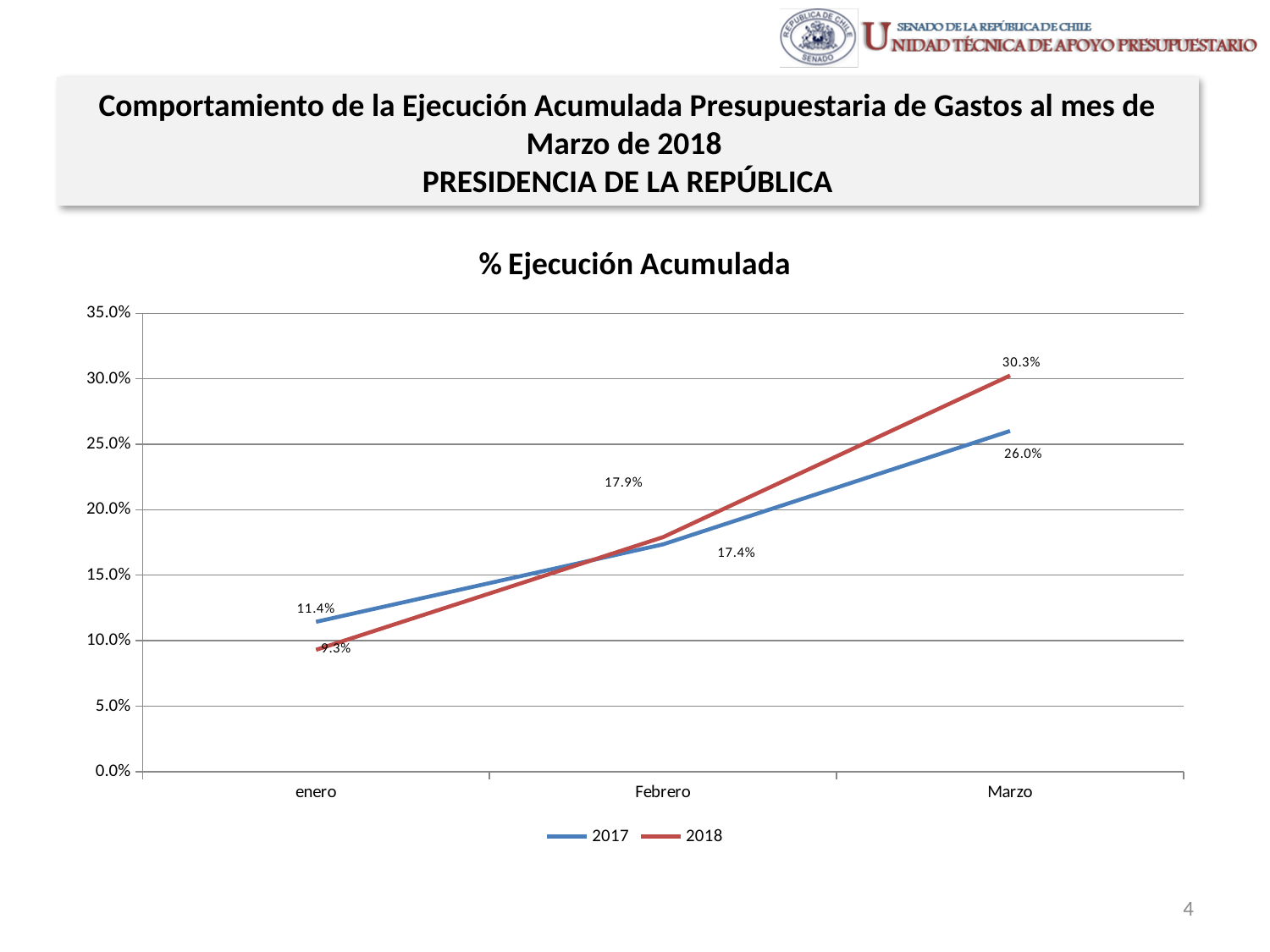
In which month is the 2018 series highest? Marzo How many months are shown on the x axis? 3 What is the difference between the 2018 and 2017 values in Marzo? 4.3% What is the value for 2018 in Marzo? 30.3% What is the value for 2017 in enero? 11.4% What type of chart is shown on the slide? line chart Does the 2017 series rise or fall from enero to Marzo? rise What is the value for 2018 in enero? 9.3% How many series does the legend list? 2 What is the title of the chart? % Ejecución Acumulada What is the value for 2017 in Marzo? 26.0% Which series has the larger value in Marzo, 2017 or 2018? 2018